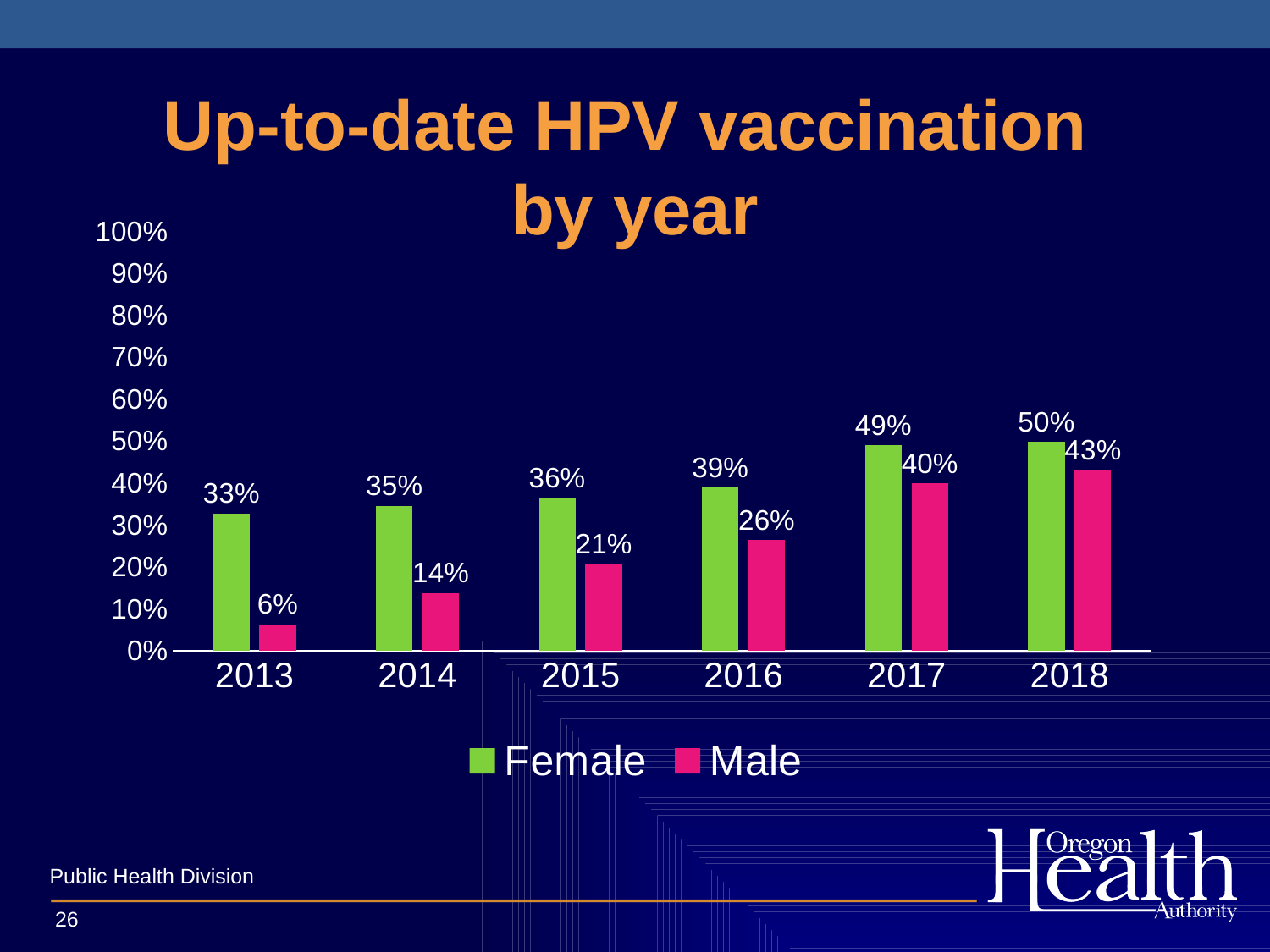
Is the Male value for 2015 greater or less than 30%? less What is the difference between the Female and Male values in 2014? 21% What is the Female value for 2013? 33% How many years are shown on the x axis? 6 What is the difference between the Male values for 2018 and 2013? 37% Which year has the lowest Male value? 2013 Which year has the highest Female value? 2018 What is the Male value for 2016? 26% Do the Male values rise or fall from 2013 to 2018? rise Which is larger, the Female value for 2017 or the Male value for 2018? Female value for 2017 How many series does the legend list? 2 What is the Male value for 2018? 43%